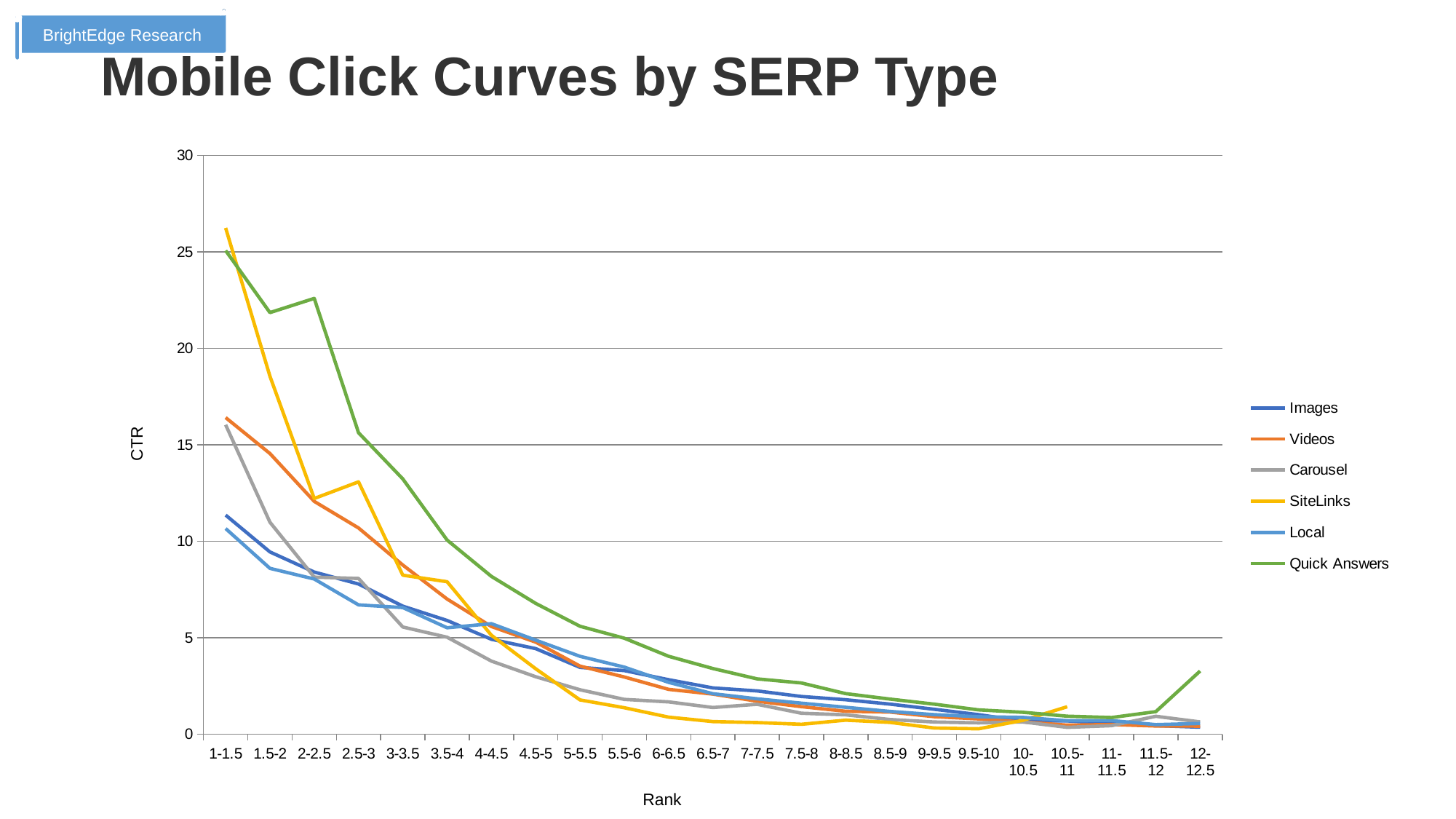
Is the CTR for Images at rank 4-4.5 greater or less than 10? less Is the CTR for SiteLinks at rank 1-1.5 greater or less than 25? greater Is the CTR for Videos at rank 1-1.5 greater or less than 15? greater Which series has the highest CTR at rank 12-12.5? Quick Answers Does the CTR for Quick Answers generally rise or fall from rank 1-1.5 to rank 9.5-10? Fall What kind of chart is shown on the slide? Line chart Which series has the highest CTR at rank 2-2.5? Quick Answers How many series does the legend list? 6 What is the label on the y axis of the chart? CTR At rank 1-1.5, which has the higher CTR: Videos or Images? Videos How many rank categories are shown along the x axis? 23